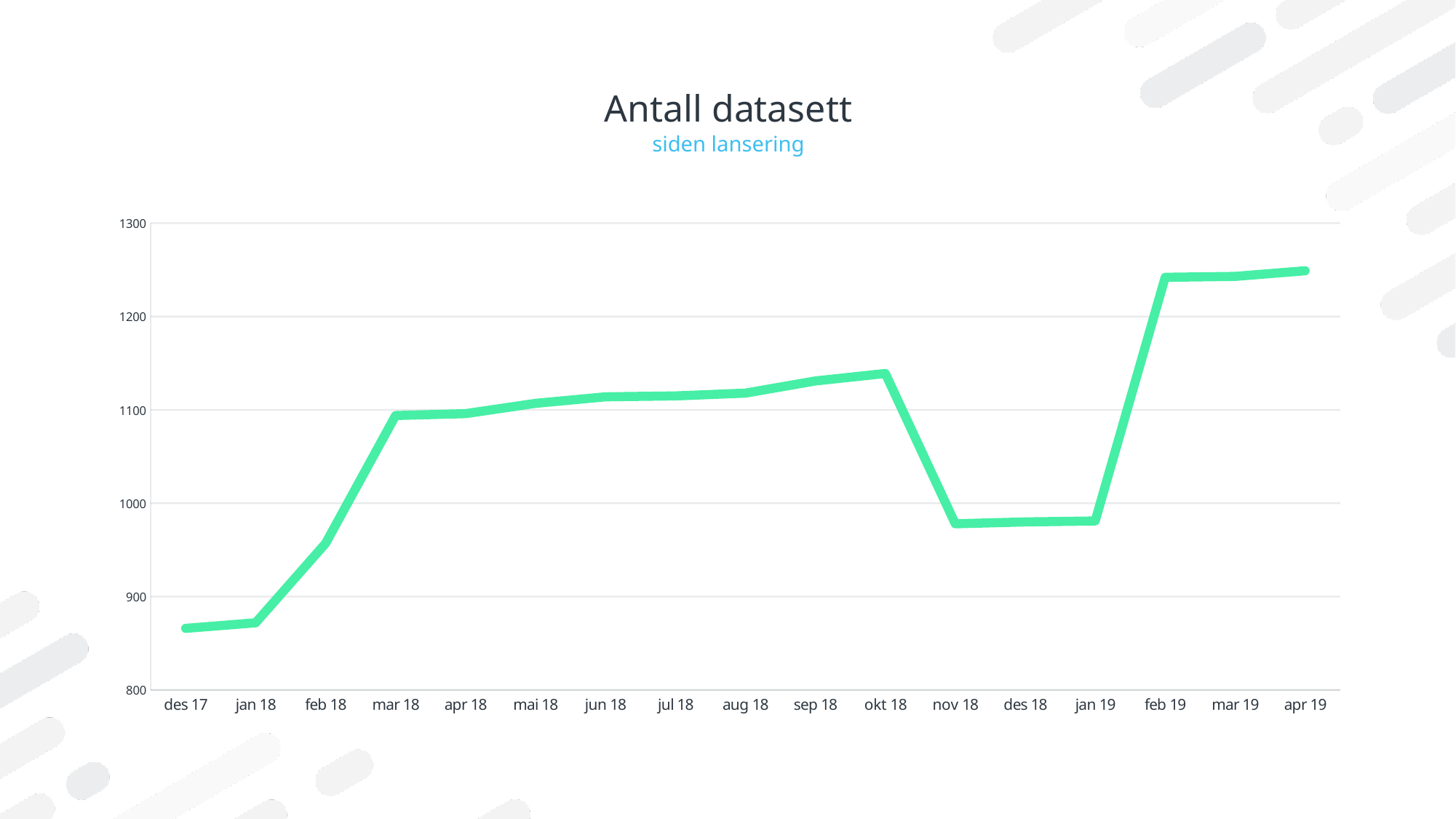
What kind of chart is shown on the slide? line chart Is the value for feb 19 greater or less than 1200? greater What is the title of the chart? Antall datasett Which is larger, the value for jan 19 or the value for feb 19? feb 19 Is the value for okt 18 greater or less than 1100? greater Which is larger, the value for okt 18 or the value for nov 18? okt 18 Is the value for mar 18 greater or less than 1000? greater How many months are plotted along the x axis? 17 What subtitle appears under the chart title? siden lansering Do the values rise or fall from des 17 to mar 18? rise